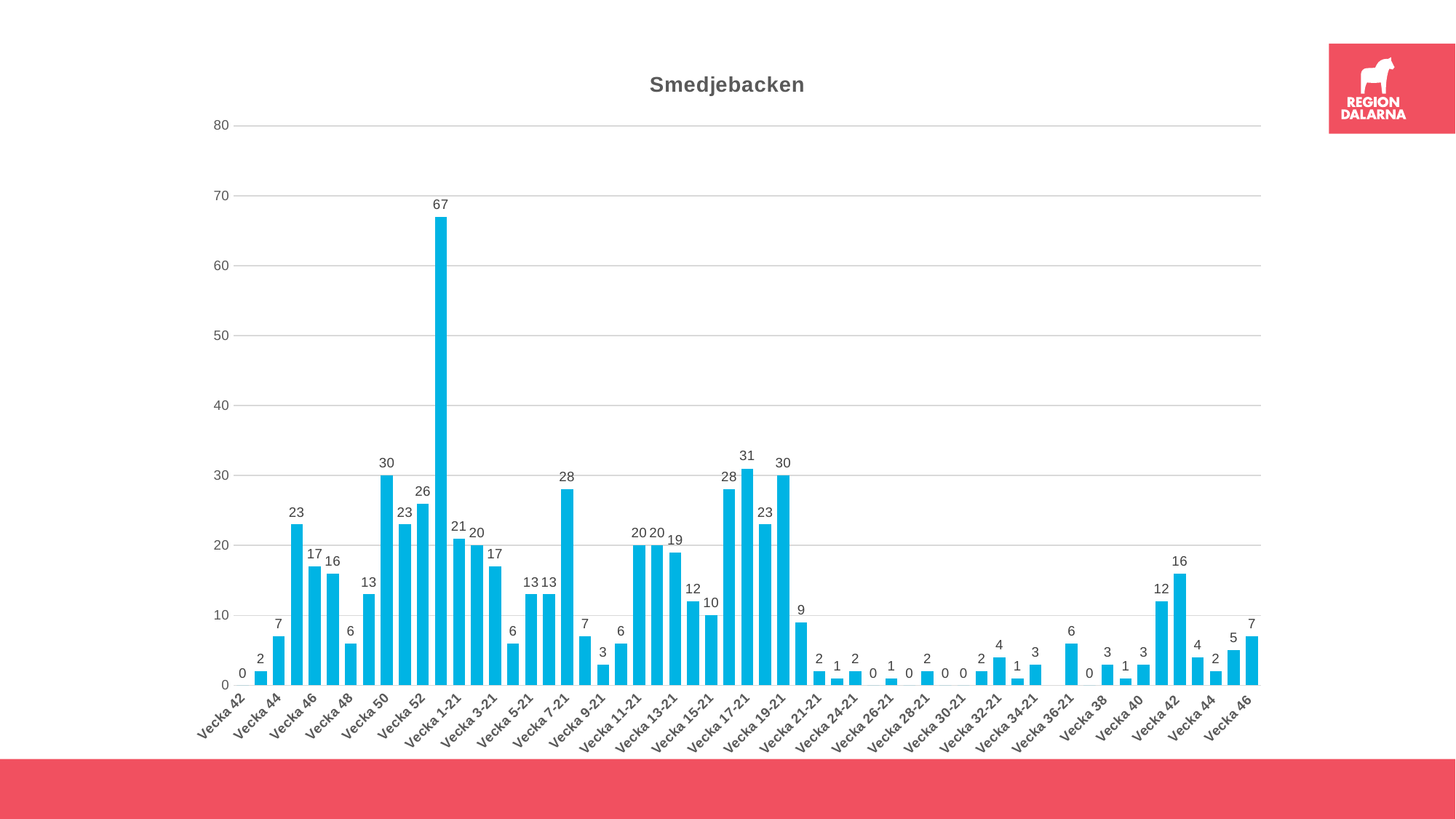
What kind of chart is shown on the slide? bar chart Which has the larger value, Vecka 11-21 or Vecka 9-21? Vecka 11-21 What is the difference between the values for Vecka 50 and Vecka 52? 4 What is the value for Vecka 50? 30 What is the value for Vecka 7-21? 28 What is the value for Vecka 17-21? 31 Is the value of the tallest bar greater or less than 60? greater What is the value for Vecka 13-21? 19 What is the value for Vecka 42 at the far left of the chart? 0 What is the value for Vecka 1-21? 21 What is the highest value shown in the chart? 67 What is the title of the chart? Smedjebacken